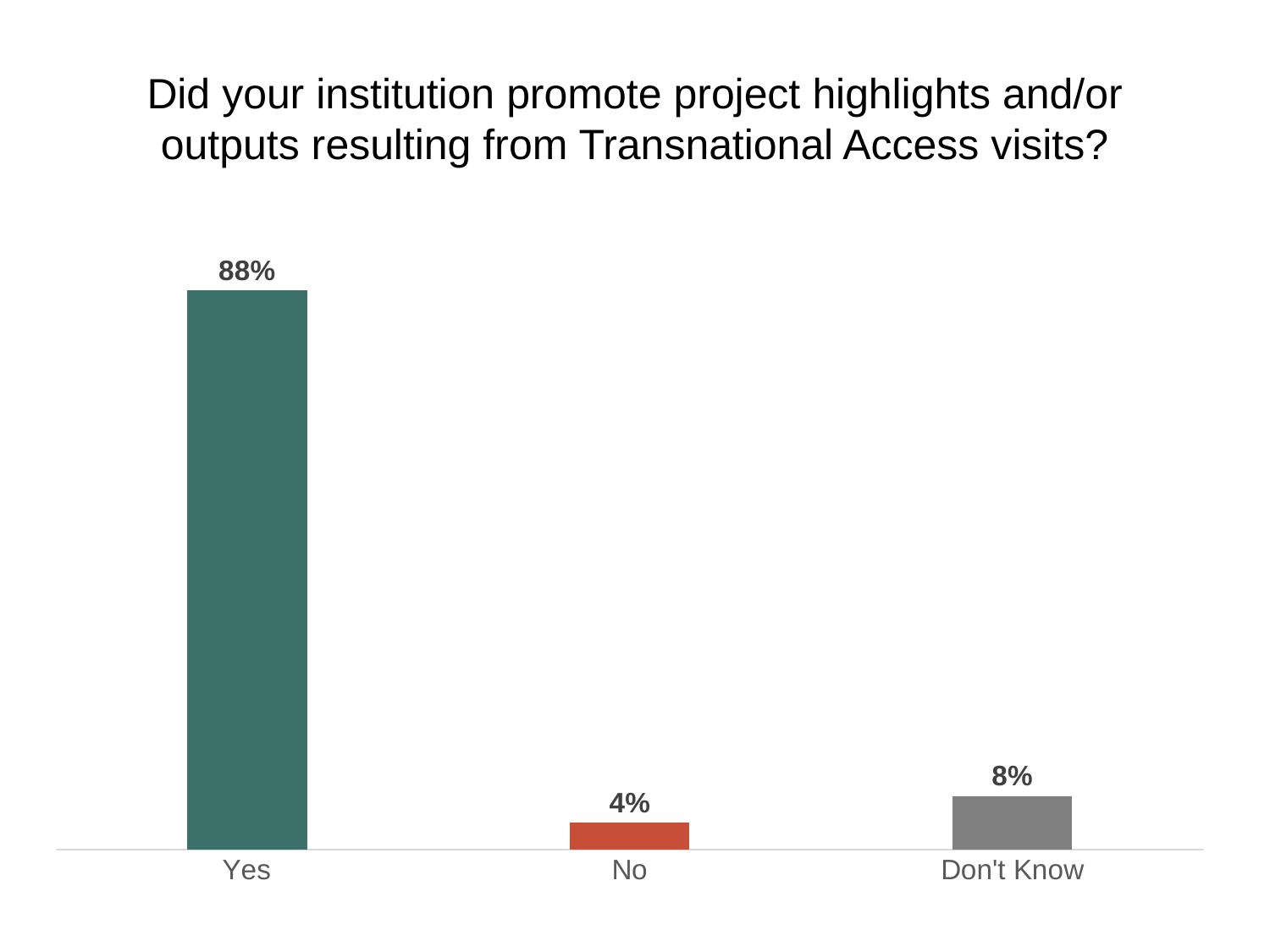
What percentage of respondents answered No? 4% What kind of chart is shown on the slide? Bar chart Which is larger, the value for No or the value for Don't Know? Don't Know What colour is the bar for the No category? Red What is the difference between the Yes and No percentages? 84% How many response categories are shown on the chart? 3 What is the difference between the Don't Know and No percentages? 4% What percentage of respondents answered Yes? 88% What is the title of the chart? Did your institution promote project highlights and/or outputs resulting from Transnational Access visits? What percentage of respondents answered Don't Know? 8% Which response category has the highest value? Yes Which response category has the lowest value? No